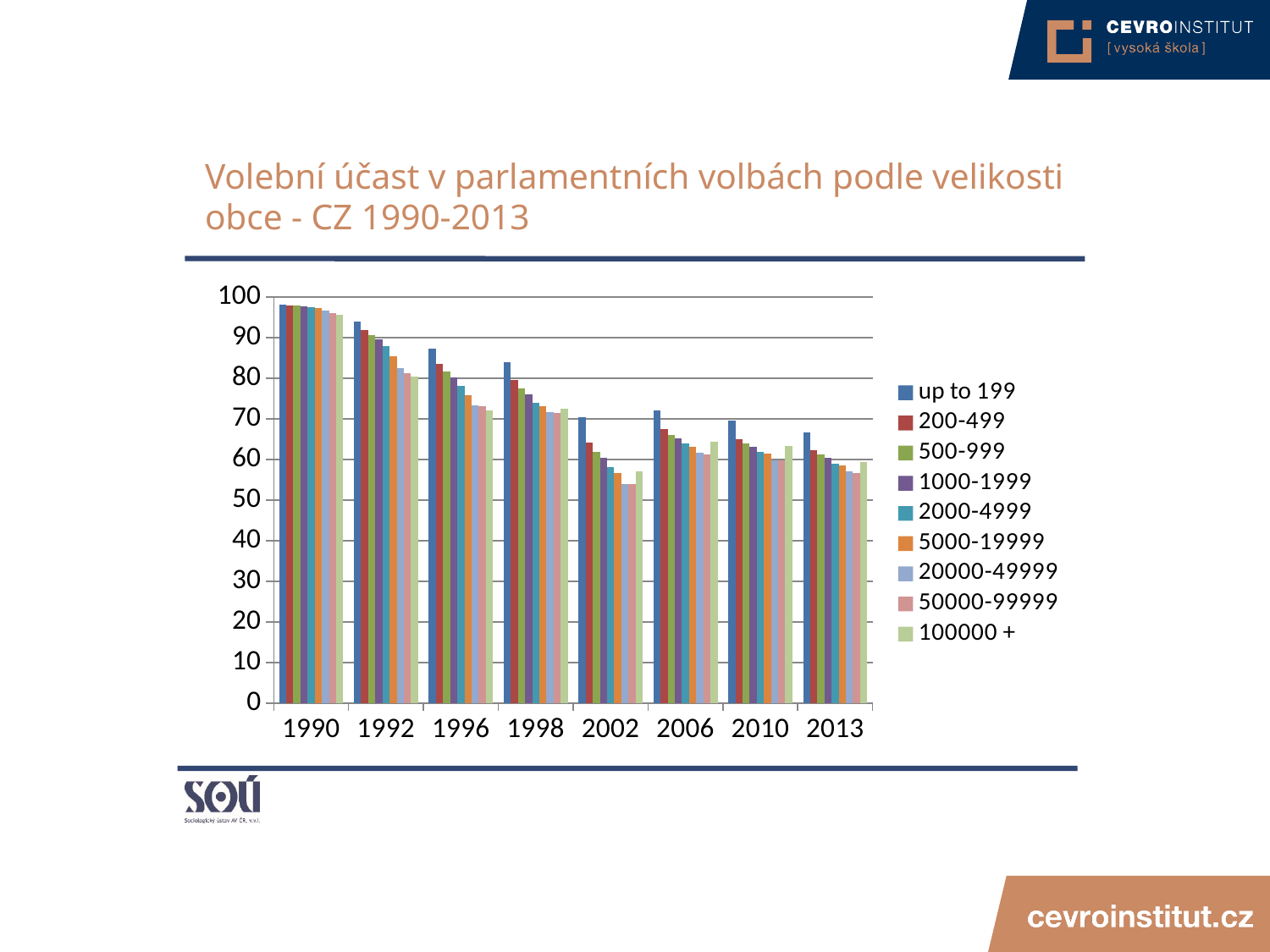
Which legend entry represents the largest municipality size category? 100000 + Is the value for '50000-99999' in 2002 greater or less than 60? less Is the value for 'up to 199' in 2013 greater or less than 60? greater What is the title of the chart on the slide? Volební účast v parlamentních volbách podle velikosti obce - CZ 1990-2013 How many election years are shown on the x axis of the chart? 8 Is the value for 'up to 199' in 1990 greater or less than 90? greater In which year is the value for '50000-99999' the lowest? 2002 In which year is the value for 'up to 199' the highest? 1990 How many series does the chart's legend list? 9 What kind of chart is shown on the slide? bar chart In 2002, which is larger: the value for 'up to 199' or the value for '50000-99999'? up to 199